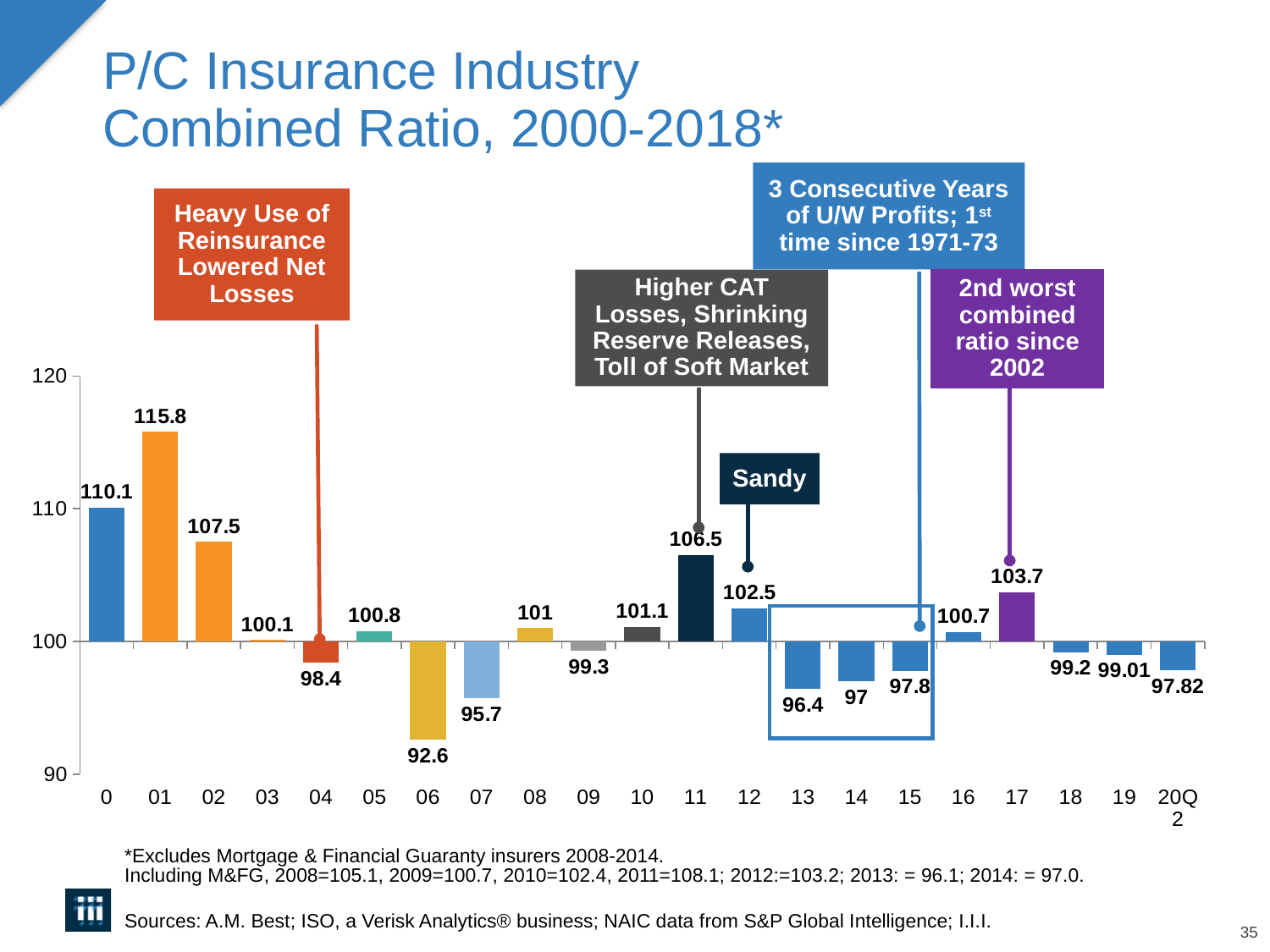
What is the combined ratio shown for 20Q2? 97.82 Is the value for 13 greater or less than 100? less Which year has the lowest combined ratio on the chart? 06 Which year has the highest combined ratio on the chart? 01 What is the combined ratio shown for 17? 103.7 What is the difference between the combined ratio for 11 and the combined ratio for 12? 4 What is the combined ratio shown for 01? 115.8 Which year's bar is labelled with the 'Sandy' callout? 12 What is the combined ratio shown for 06? 92.6 How many bars are plotted on the chart? 21 What kind of chart is shown on the slide? bar chart Which is larger, the combined ratio for 0 or the combined ratio for 02? 0